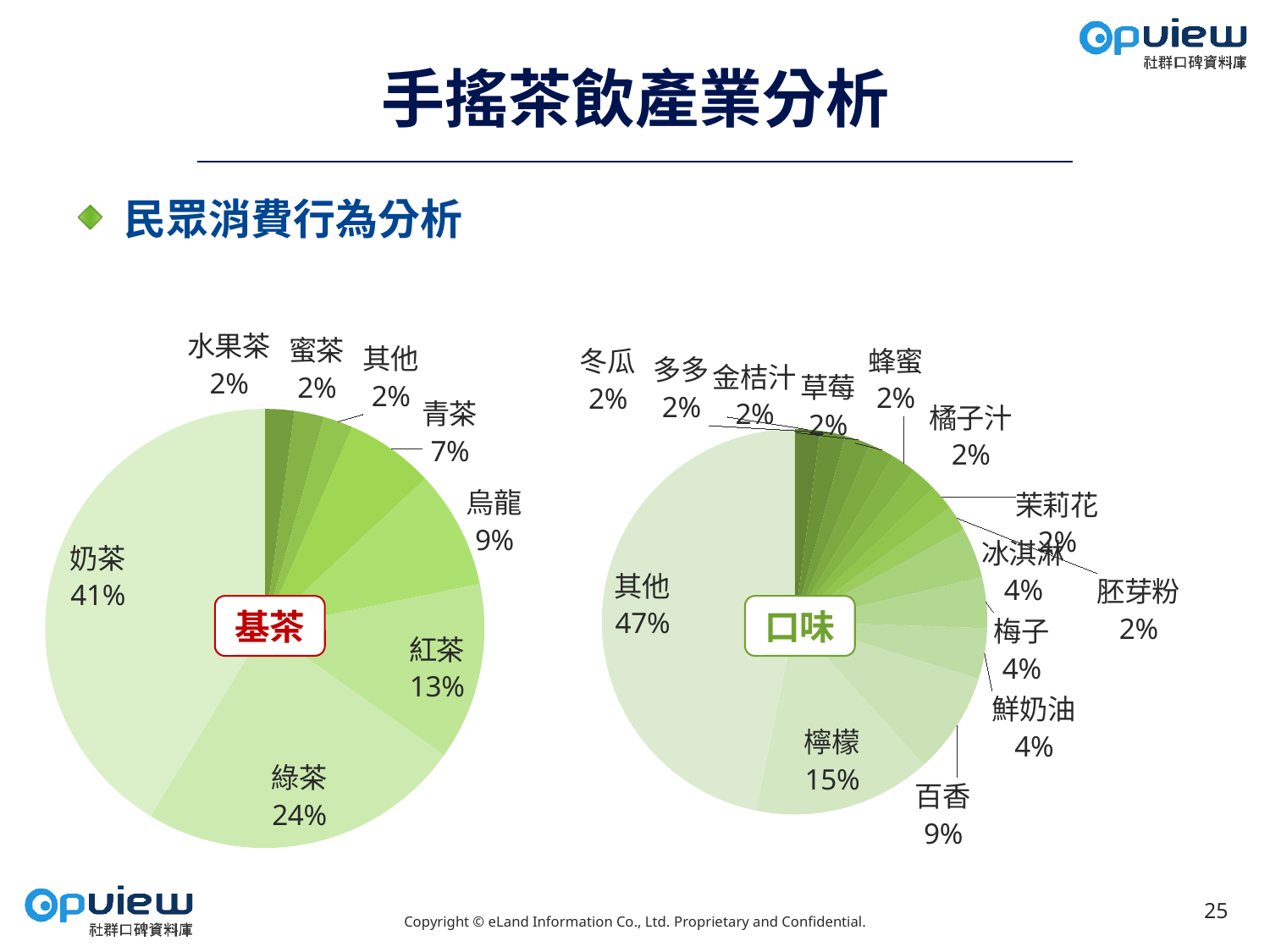
In the 基茶 pie chart on the left, what share does 奶茶 have? 41% How many categories are shown in the 口味 pie chart on the right? 14 In the 基茶 pie chart on the left, what share does 綠茶 have? 24% In the 基茶 pie chart on the left, what is the difference between the shares of 紅茶 and 烏龍? 4% In the 口味 pie chart on the right, which category has the largest share? 其他 In the 基茶 pie chart on the left, which has a larger share, 青茶 or 烏龍? 烏龍 In the 口味 pie chart on the right, what share does 百香 have? 9% How many categories are shown in the 基茶 pie chart on the left? 8 What type of chart is used for the 基茶 chart on the left? Pie chart In the 基茶 pie chart on the left, which category has the largest share? 奶茶 In the 口味 pie chart on the right, what is the difference between the shares of 檸檬 and 百香? 6% In the 口味 pie chart on the right, what share does 檸檬 have? 15%